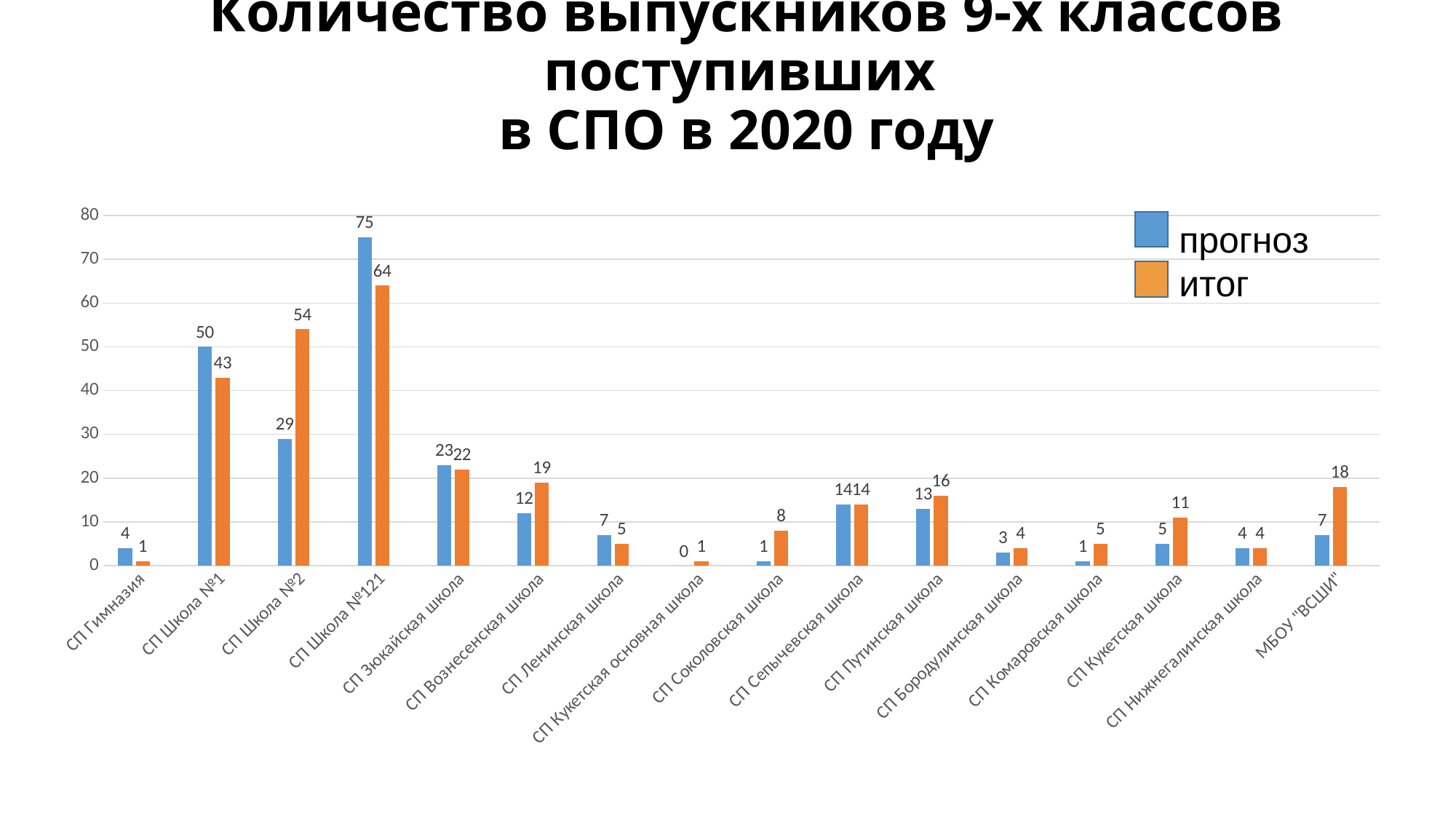
What is the прогноз value for СП Школа №121? 75 What is the итог value for СП Школа №2? 54 Which is larger for СП Вознесенская школа, the прогноз value or the итог value? итог How many categories are shown on the x axis? 16 What is the difference between the прогноз and итог values for СП Школа №1? 7 What is the итог value for СП Соколовская школа? 8 Which colour represents the итог series in the legend? orange Which category has the highest прогноз value? СП Школа №121 How many series does the legend list? 2 What kind of chart is shown on the slide? bar chart What is the итог value for МБОУ "ВСШИ"? 18 Which category has the lowest прогноз value? СП Кукетская основная школа